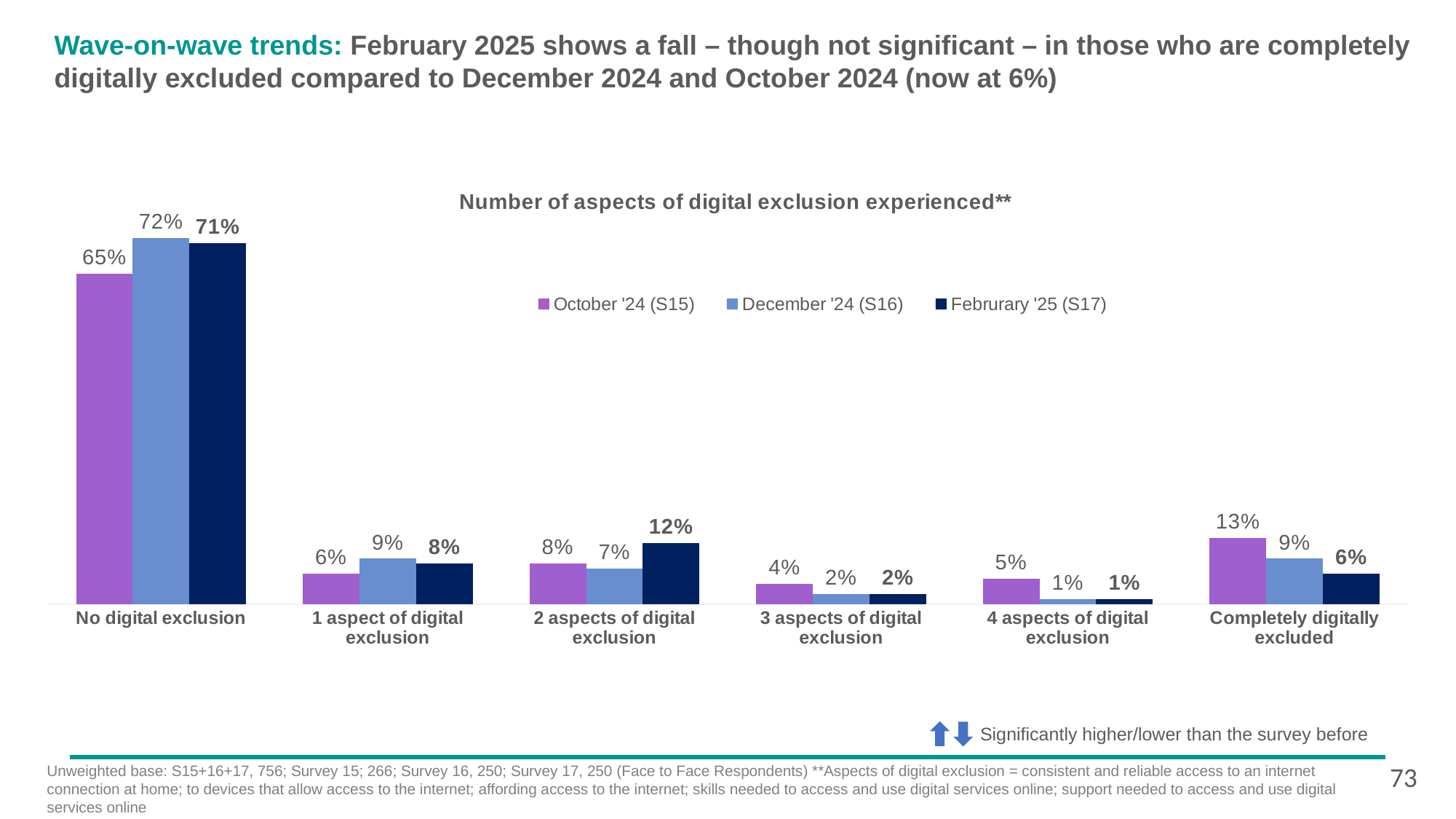
What is the value for 'Completely digitally excluded' in the October '24 (S15) series? 13% What is the value for '2 aspects of digital exclusion' in the December '24 (S16) series? 7% What kind of chart is shown on the slide? Bar chart Which series is shown in purple? October '24 (S15) What is the value for 'No digital exclusion' in the February '25 (S17) series? 71% Which category has the lowest value in the February '25 (S17) series? 4 aspects of digital exclusion How many series does the legend list? 3 How many categories are shown on the x axis? 6 What is the difference between the October '24 (S15) and February '25 (S17) values for 'Completely digitally excluded'? 7% Which is larger for '2 aspects of digital exclusion': the October '24 (S15) value or the February '25 (S17) value? February '25 (S17) What is the title of the chart? Number of aspects of digital exclusion experienced** Which category has the highest value in the December '24 (S16) series? No digital exclusion